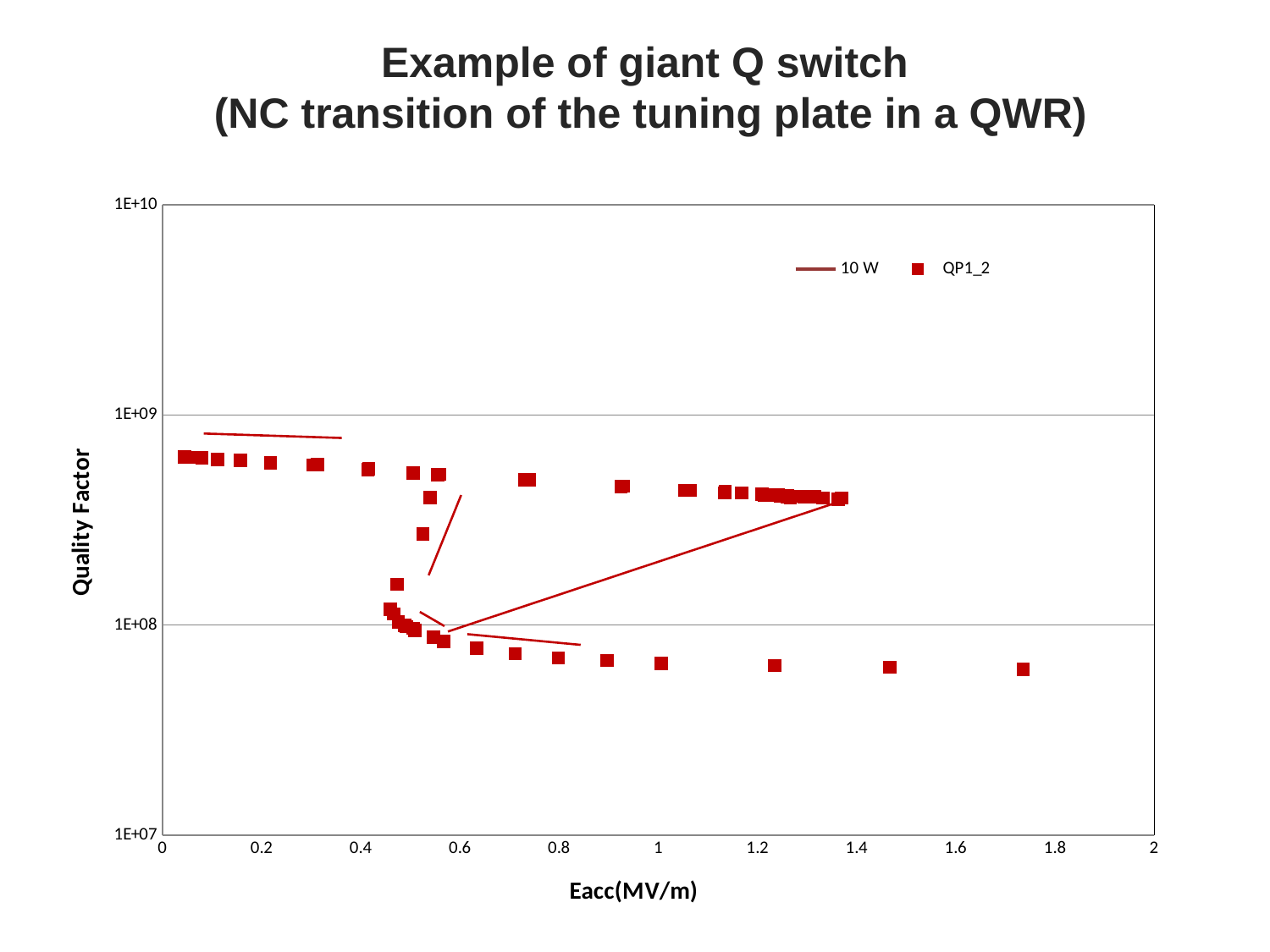
Where along the x axis is the highest QP1_2 quality factor found? At the far left (Eacc near 0) Overall, do the QP1_2 quality factor values rise or fall as Eacc increases from 0 to 2? Fall What kind of chart is shown on the slide? Scatter chart Are any QP1_2 points plotted above 1E+09? No Is the QP1_2 value at the far left of the chart (Eacc near 0) greater or less than 1E+08? greater Is the QP1_2 value at the far right of the chart (Eacc around 1.7) greater or less than 1E+08? less What are the two entries in the chart legend? 10 W and QP1_2 How many series does the legend list? 2 Which is larger: the QP1_2 quality factor at Eacc around 0.2 or at Eacc around 1.0? Eacc around 0.2 What is the title of the x axis? Eacc(MV/m)